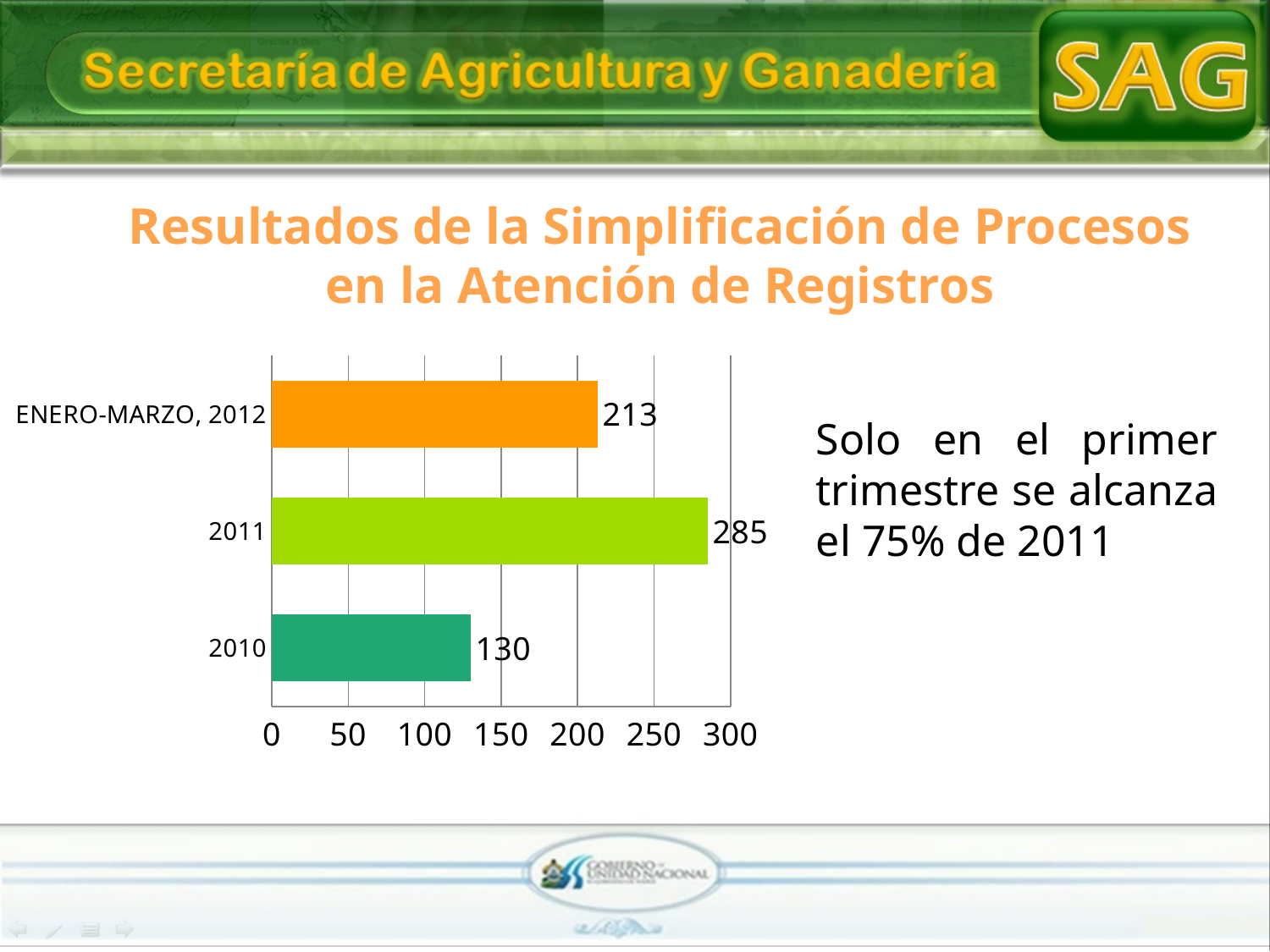
What colour is the bar for 2011? green What is the difference between the values for 2011 and 2010? 155 Is the value for 2011 greater or less than 250? greater Which category has the highest value? 2011 What is the difference between the values for 2011 and ENERO-MARZO, 2012? 72 How many categories are shown in the chart? 3 What is the value for ENERO-MARZO, 2012? 213 Which is larger, the value for ENERO-MARZO, 2012 or the value for 2010? ENERO-MARZO, 2012 What is the value for 2010? 130 Which category has the lowest value? 2010 What is the value for 2011? 285 What kind of chart is shown on the slide? bar chart